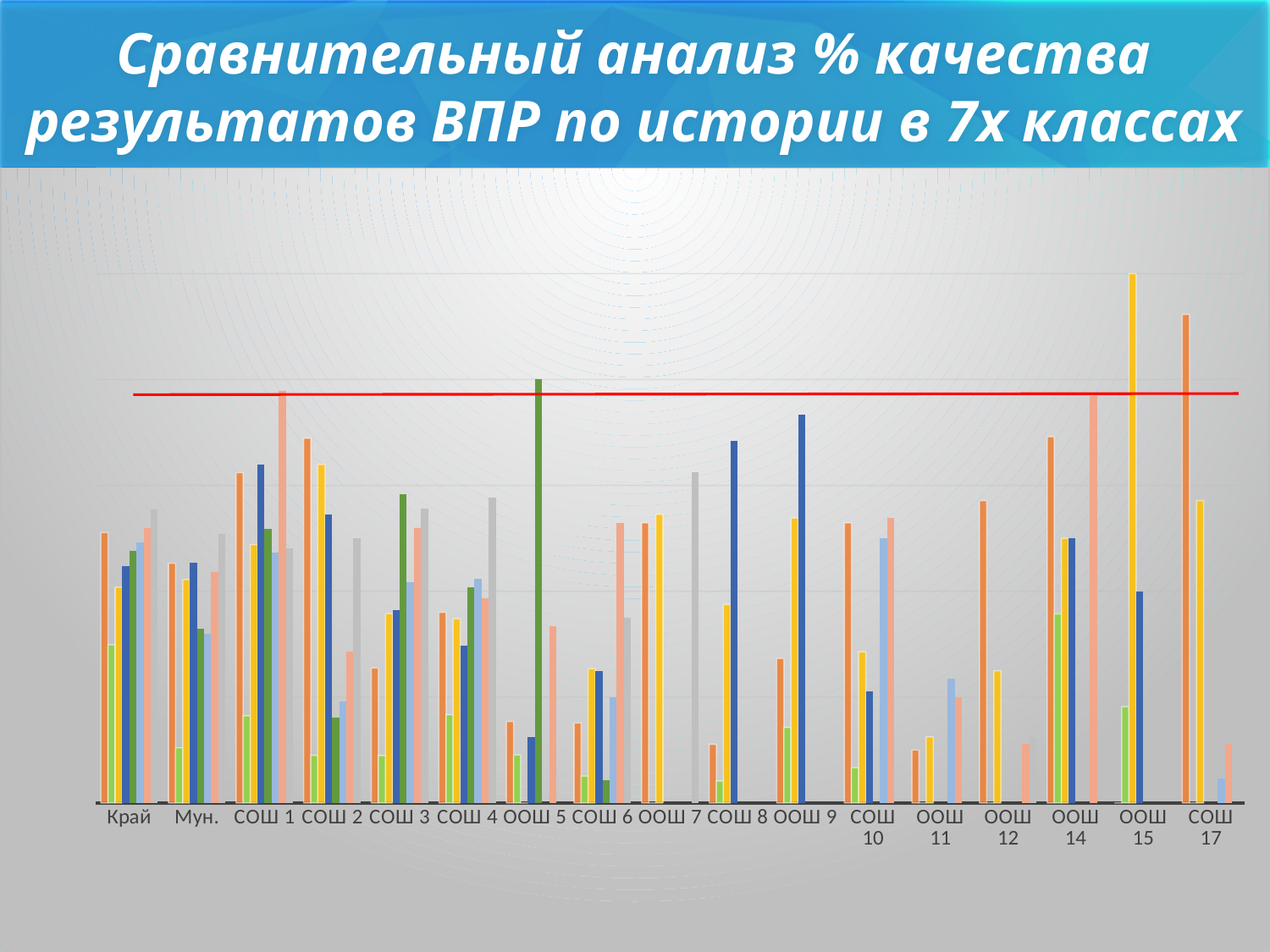
What is the label of the last category on the x axis? СОШ 17 What is the label of the first category on the x axis? Край What is the title of the chart on the slide? Сравнительный анализ % качества результатов ВПР по истории в 7х классах What colour is the horizontal reference line drawn across the chart? red What kind of chart is shown on the slide? bar chart How many categories are shown along the x axis of the chart? 17 Which category contains the single tallest bar in the chart? ООШ 15